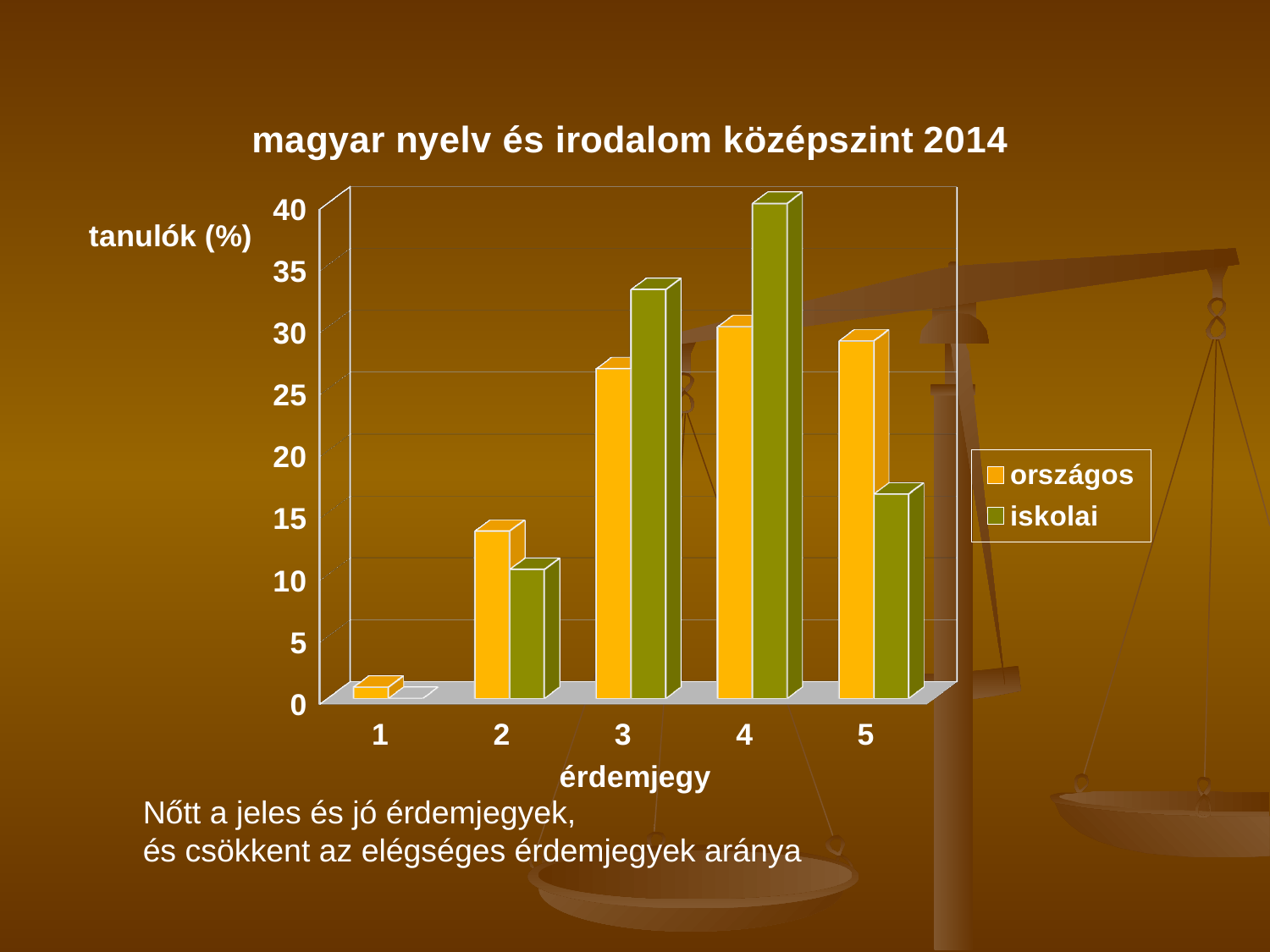
What is the title of the chart? magyar nyelv és irodalom középszint 2014 For grade 3, which series has the larger value, országos or iskolai? iskolai Is the országos value for grade 1 greater or less than 5? less Is the iskolai value for grade 5 greater or less than 20? less For which grade is the országos value lowest? 1 For grade 5, which series has the larger value, országos or iskolai? országos For grade 2, which series has the larger value, országos or iskolai? országos Is the iskolai value for grade 4 greater or less than 35? greater How many grade categories (érdemjegy) are shown on the x axis? 5 What kind of chart is shown on the slide? bar chart For which grade is the iskolai value highest? 4 How many series does the legend list? 2